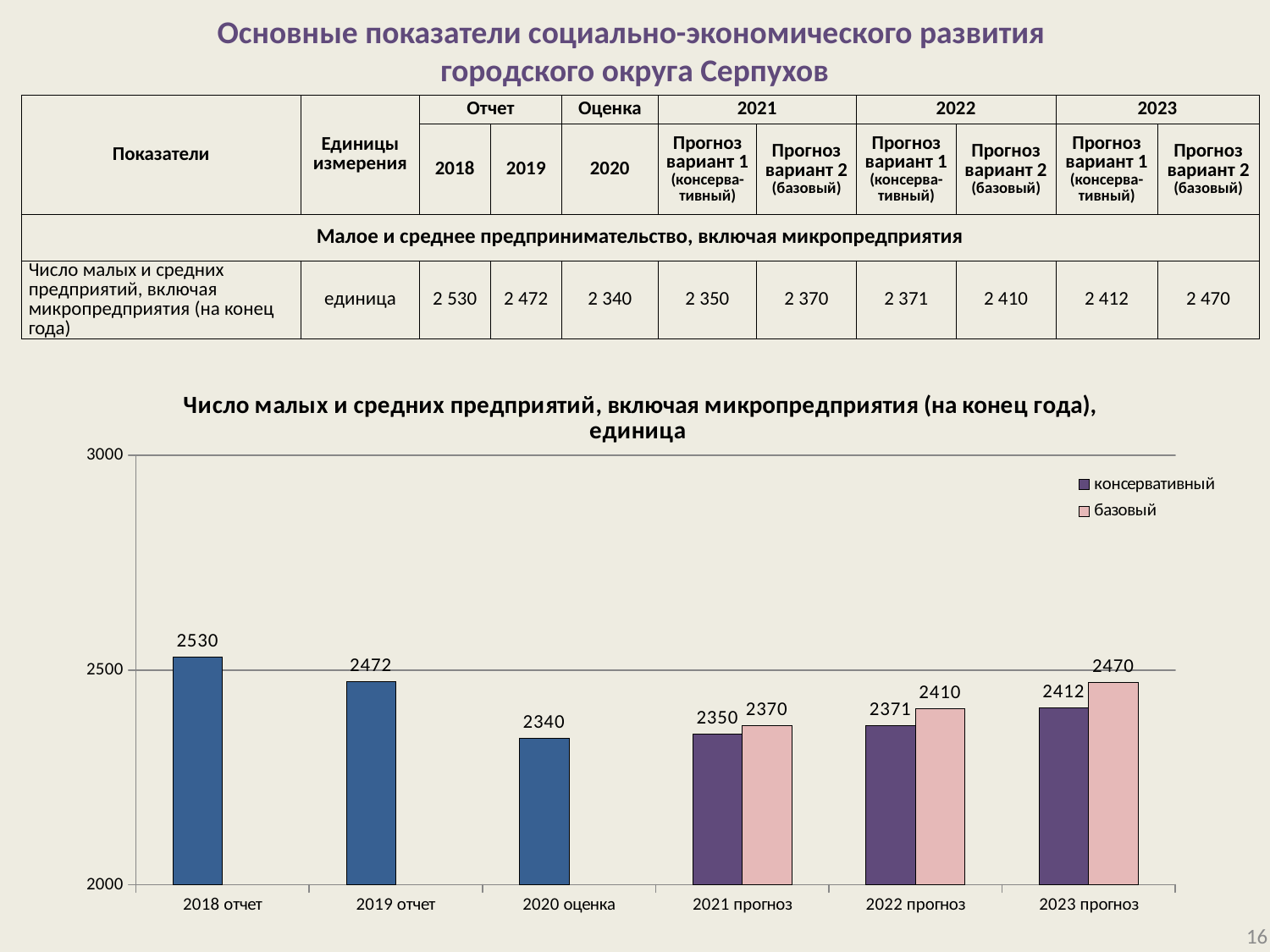
What is the value for 2018 отчет? 2530 What is the difference between the 2018 отчет and 2019 отчет values? 58 What is the difference between the базовый and консервативный values for 2022 прогноз? 39 What is the value of the консервативный series for 2022 прогноз? 2371 Which is larger: the консервативный value for 2021 прогноз or the консервативный value for 2023 прогноз? 2023 прогноз Which category has the highest value on the chart? 2018 отчет Which category has the lowest value on the chart? 2020 оценка Is the value for 2020 оценка greater or less than 2500? less What kind of chart is shown on the slide? bar chart How many categories are shown on the x axis? 6 How many series does the legend list? 2 What is the value of the базовый series for 2023 прогноз? 2470